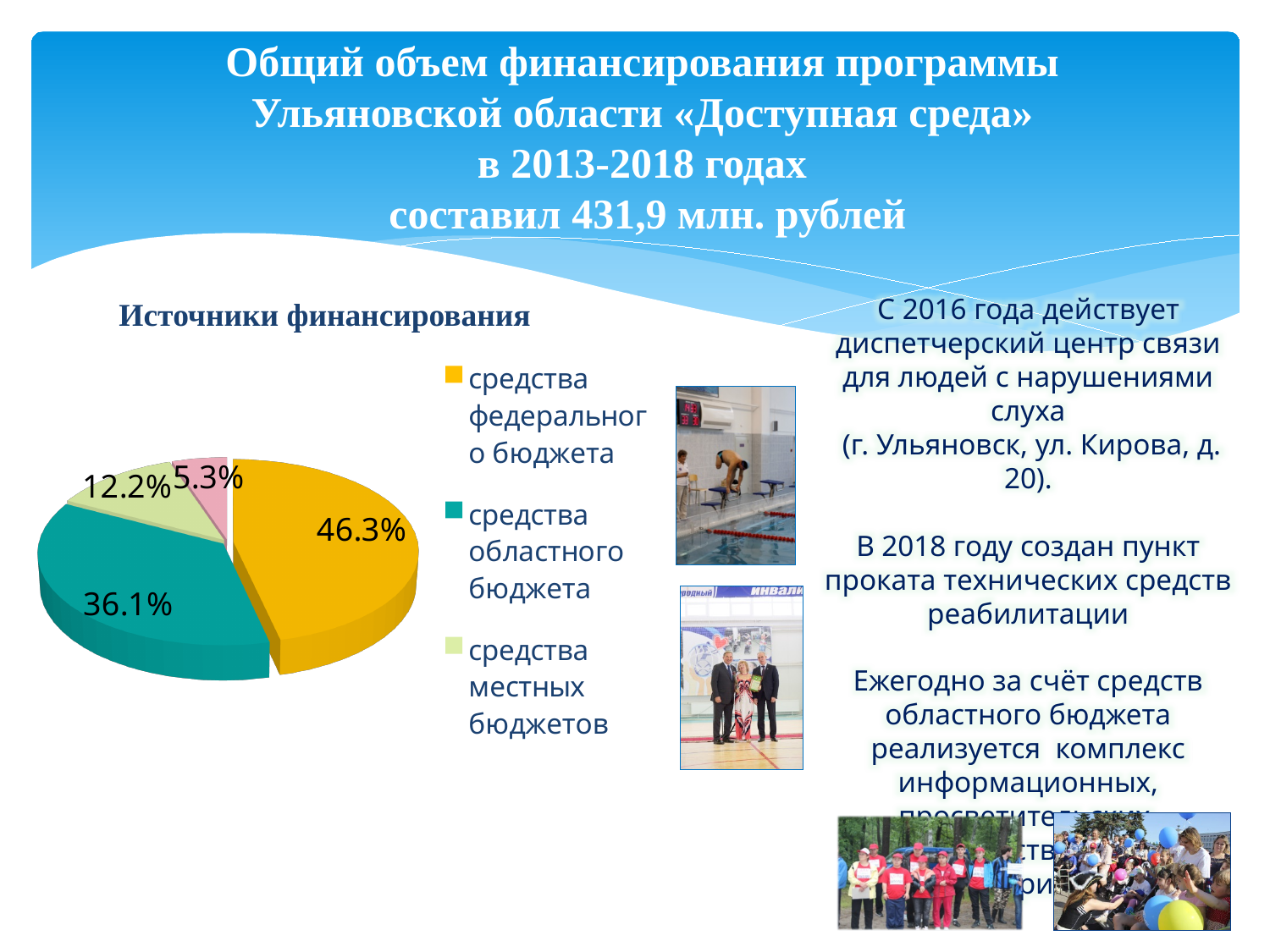
What is the smallest percentage labelled on the pie chart? 5.3% What kind of chart is shown under the heading «Источники финансирования»? pie chart Which of the three legend entries has the smallest share in the pie chart? средства местных бюджетов Which source has the largest share in the pie chart? средства федерального бюджета What share of the pie chart is «средства федерального бюджета»? 46.3% What share of the pie chart is «средства областного бюджета»? 36.1% How many entries does the pie chart's legend list? 3 What colour is the slice for «средства областного бюджета»? teal Which is larger: the share of «средства областного бюджета» or «средства местных бюджетов»? средства областного бюджета What share of the pie chart is «средства местных бюджетов»? 12.2% What is the difference in percentage points between «средства федерального бюджета» and «средства областного бюджета»? 10.2 How many slices does the pie chart have? 4